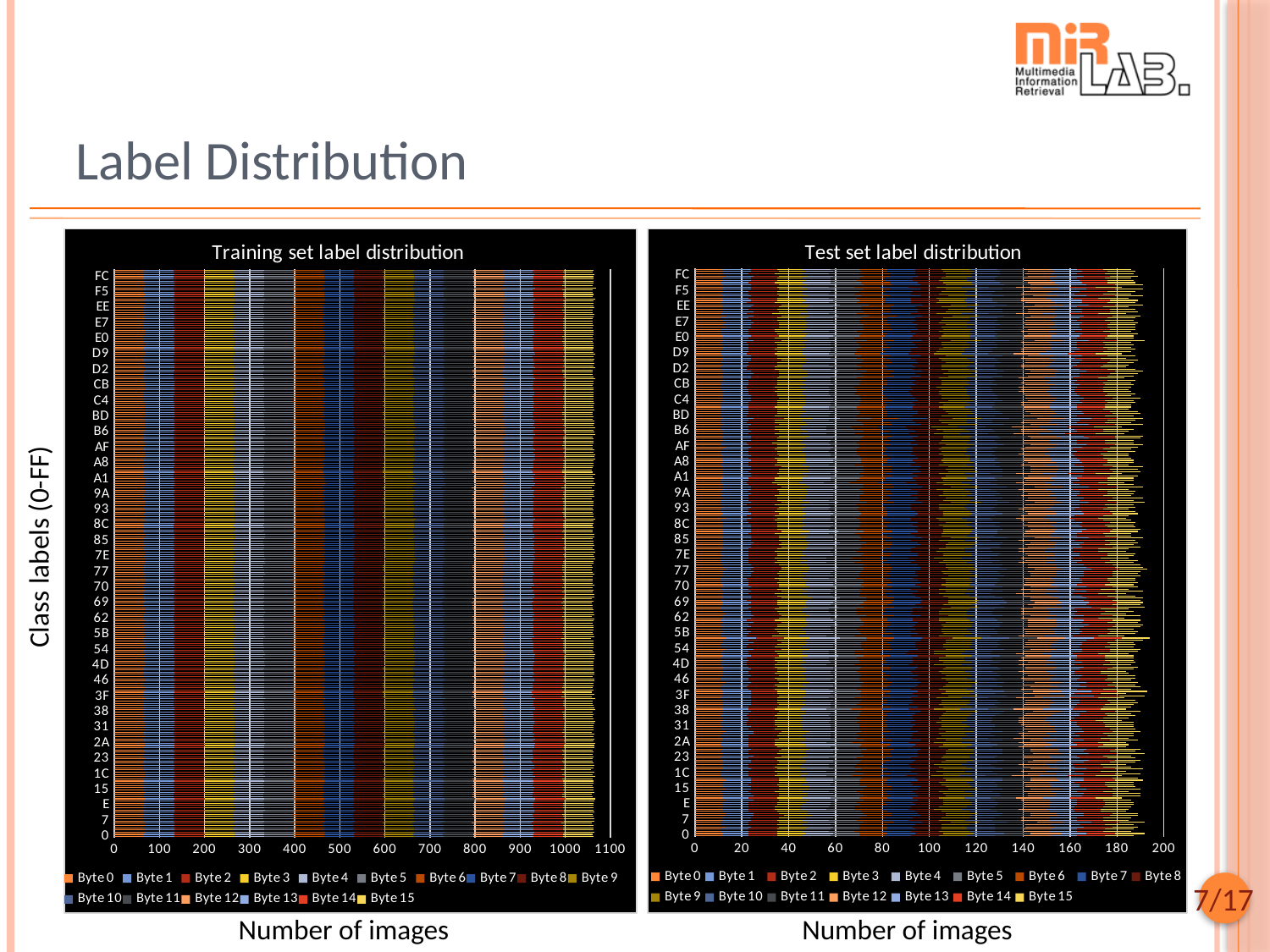
How many series does the legend of the 'Test set label distribution' chart list? 16 What kind of chart is the 'Test set label distribution' chart? Stacked bar chart What kind of chart is the 'Training set label distribution' chart? Stacked bar chart In the 'Test set label distribution' chart, what is the highest value shown on the horizontal axis? 200 In the 'Training set label distribution' chart, is the total stacked value for class FC greater or less than 900? greater In the 'Test set label distribution' chart, what is the last series named in the legend? Byte 15 What is the title of the chart on the right side of the slide? Test set label distribution In the 'Training set label distribution' chart, what is the highest value shown on the horizontal axis? 1100 In the 'Training set label distribution' chart, what is the first series named in the legend? Byte 0 How many series does the legend of the 'Training set label distribution' chart list? 16 What is the title of the chart on the left side of the slide? Training set label distribution In the 'Test set label distribution' chart, is the total stacked value for class FC greater or less than 140? greater